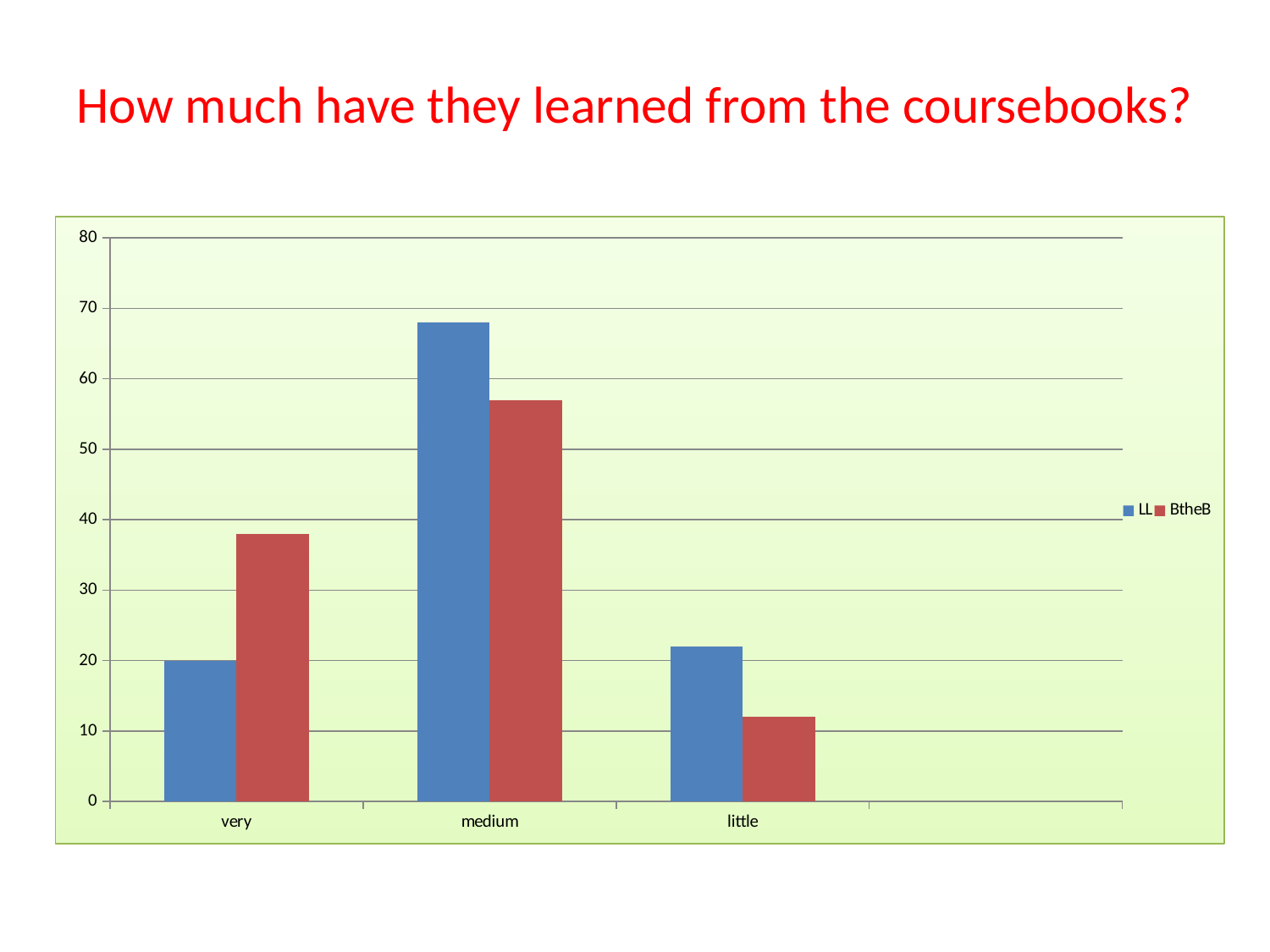
What kind of chart is shown on the slide? bar chart How many categories are shown on the x axis? 3 Is the value for BtheB in the 'very' category greater or less than 30? greater In the 'medium' category, which series has the larger value, LL or BtheB? LL Which two series are listed in the legend? LL and BtheB For which category is the BtheB series lowest? little In the 'very' category, which series has the larger value, LL or BtheB? BtheB For which category is the LL series highest? medium What is the title of the slide above the chart? How much have they learned from the coursebooks? Is the value for BtheB in the 'little' category greater or less than 20? less Is the value for LL in the 'medium' category greater or less than 60? greater How many series does the legend list? 2